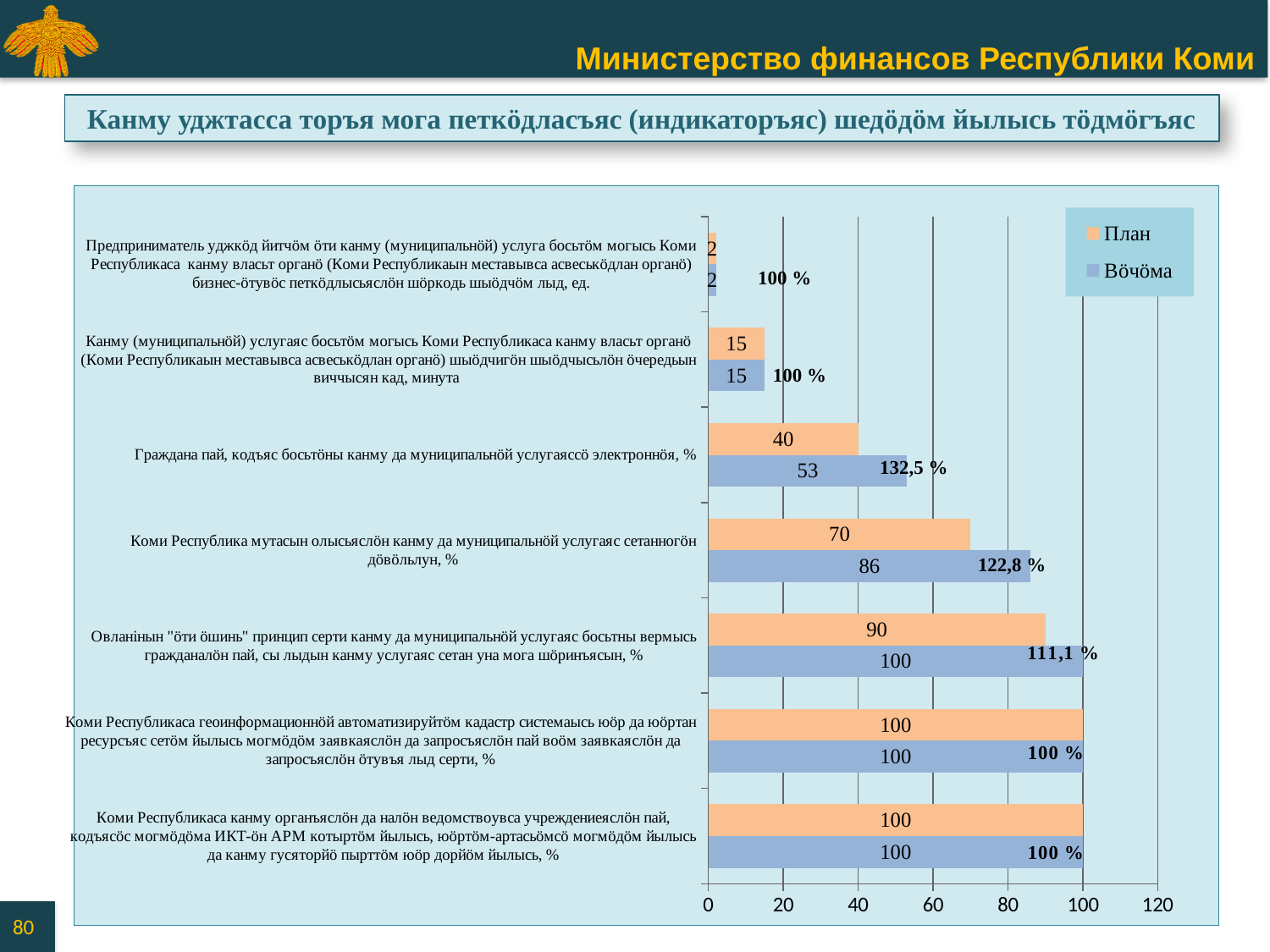
What is the difference between the Вöчöма and План values for the indicator "Коми Республика мутасын олысьяслöн канму да муниципальнöй услугаяс сетанногöн дöвöльлун, %"? 16 How many categories (indicators) are plotted on the chart? 7 What are the two series named in the legend? План and Вöчöма What percentage label is shown for the indicator "Коми Республика мутасын олысьяслöн канму да муниципальнöй услугаяс сетанногöн дöвöльлун, %"? 122,8 % What is the План value for the indicator about waiting time in minutes ("...шыöдчысьлöн öчередьын виччысян кад, минута")? 15 For the indicator "Овланiнын "öти öшинь" принцип серти...", which is larger, the План value or the Вöчöма value? Вöчöма What percentage label is shown next to the bars for the indicator "Граждана пай, кодъяс босьтöны канму да муниципальнöй услугаяссö электроннöя, %"? 132,5 % What is the Вöчöма value for the indicator "Граждана пай, кодъяс босьтöны канму да муниципальнöй услугаяссö электроннöя, %"? 53 What kind of chart is shown on the slide? bar chart Which indicator has the lowest План value? Предприниматель уджкöд йитчöм öти канму (муниципальнöй) услуга босьтöм могысь... бизнес-öтувöс петкöдлысьяслöн шöркодь шыöдчöм лыд, ед. How many series does the legend list? 2 What is the План value for the indicator "Коми Республика мутасын олысьяслöн канму да муниципальнöй услугаяс сетанногöн дöвöльлун, %"? 70